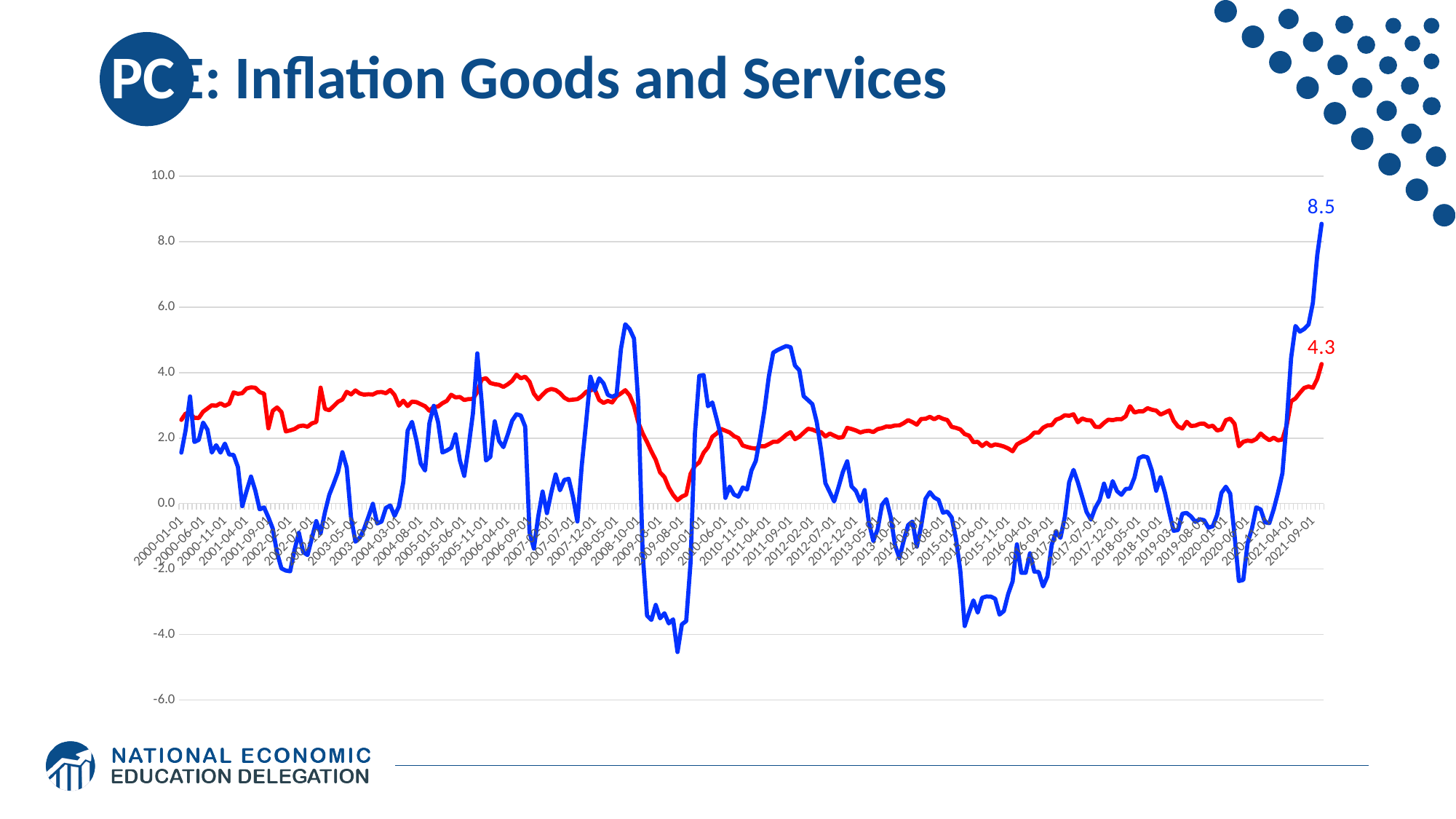
Is the value of the red line at 2000-01-01 greater or less than 2.0? greater What kind of chart is shown on the slide? line chart Is the lowest point of the blue line, around 2009, greater or less than -4.0? less What is the final labelled value of the blue line? 8.5 What is the title of the slide? PCE: Inflation Goods and Services Which line reaches the highest value on the chart? blue What is the final labelled value of the red line? 4.3 At the end of the series, which line has the larger labelled value, the blue or the red? blue Is the peak of the blue line around 2008 greater or less than 4.0? greater Which line reaches the lowest value on the chart? blue What is the difference between the final labelled values of the blue line (8.5) and the red line (4.3)? 4.2 How many lines are plotted on the chart? 2